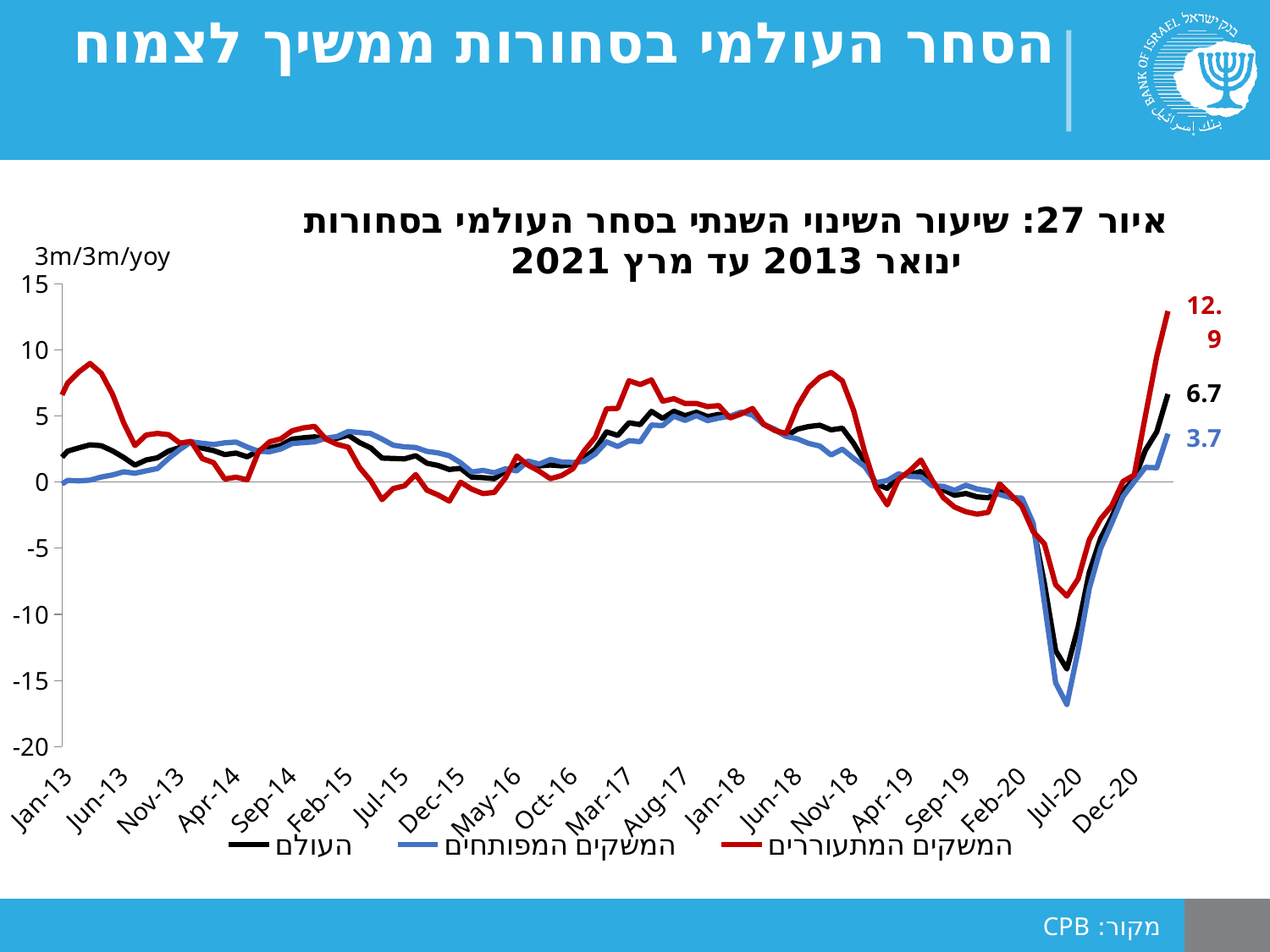
Which series has the lowest labelled value at the end of the chart? המשקים המפותחים What source is cited for the chart? CPB At the end of the chart, which is larger: the labelled value for העולם or for המשקים המפותחים? העולם What is the difference between the final labelled values of המשקים המתעוררים and העולם? 6.2 What is the final labelled value for the העולם series? 6.7 What kind of chart is shown on the slide? line chart Do the series rise or fall between Jul-20 and the end of the chart? rise What is the final labelled value for the המשקים המפותחים series? 3.7 How many series does the legend list? 3 Is the lowest value of the המשקים המפותחים series around Jul-20 greater or less than -15? less Which series has the highest labelled value at the end of the chart? המשקים המתעוררים What is the final labelled value for the המשקים המתעוררים series? 12.9